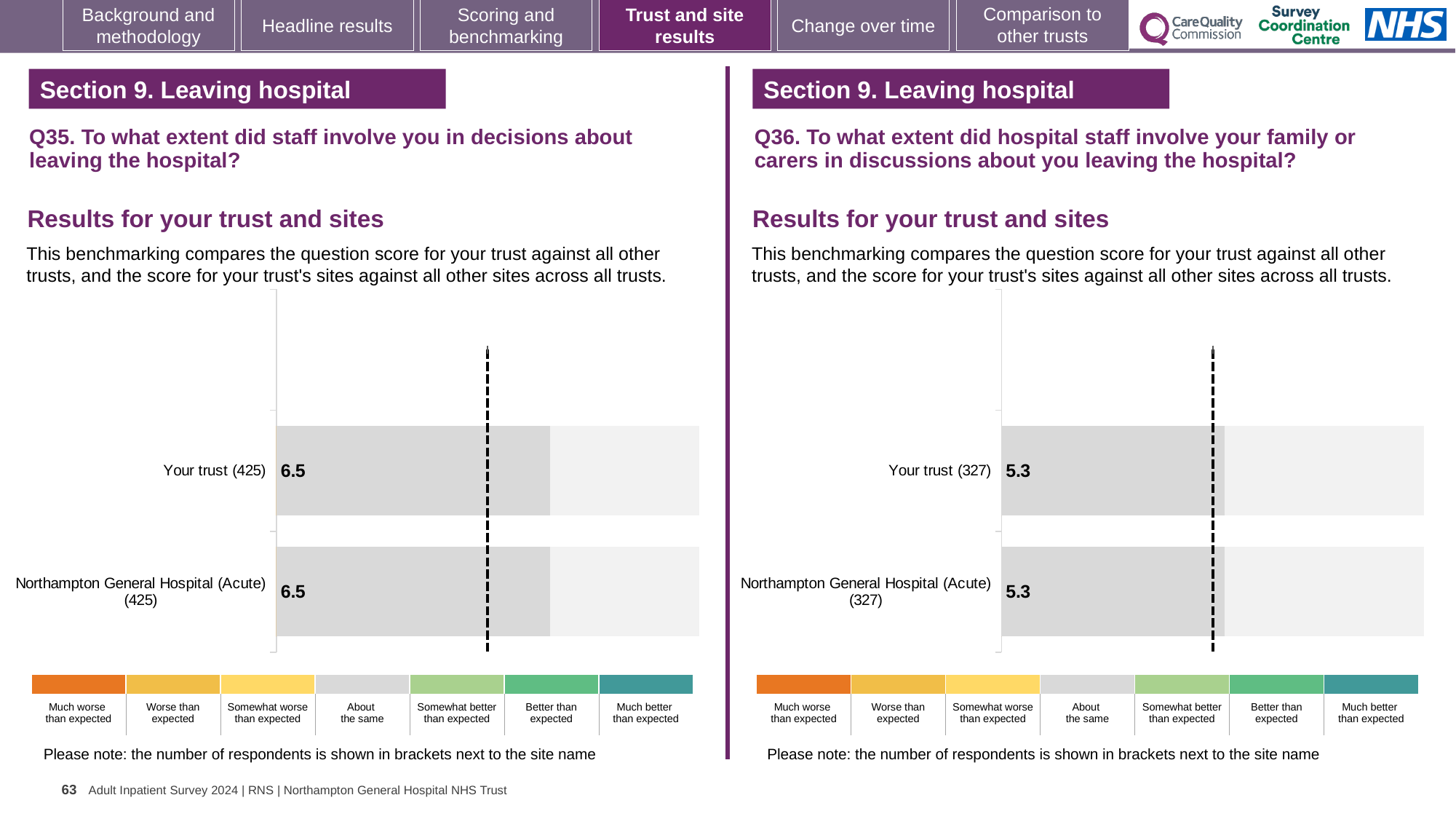
How many bars are plotted in the Q35 chart on the left? 2 In the Q35 chart on the left, what is the score for Your trust? 6.5 In the Q35 chart on the left, what is the score for Northampton General Hospital (Acute)? 6.5 What kind of chart is used for the Q36 results on the right? bar chart In the Q36 chart on the right, is the score for Your trust larger than, smaller than, or the same as the score for Northampton General Hospital (Acute)? the same In the Q36 chart on the right, what is the score for Your trust? 5.3 In the Q35 chart on the left, how many respondents are shown in brackets for Your trust? 425 In the Q35 chart on the left, what is the difference between the score for Your trust and the score for Northampton General Hospital (Acute)? 0 In the Q36 chart on the right, what is the score for Northampton General Hospital (Acute)? 5.3 How many categories does the colour key below the Q35 chart on the left list? 7 How many bars are plotted in the Q36 chart on the right? 2 In the Q36 chart on the right, how many respondents are shown in brackets for Northampton General Hospital (Acute)? 327